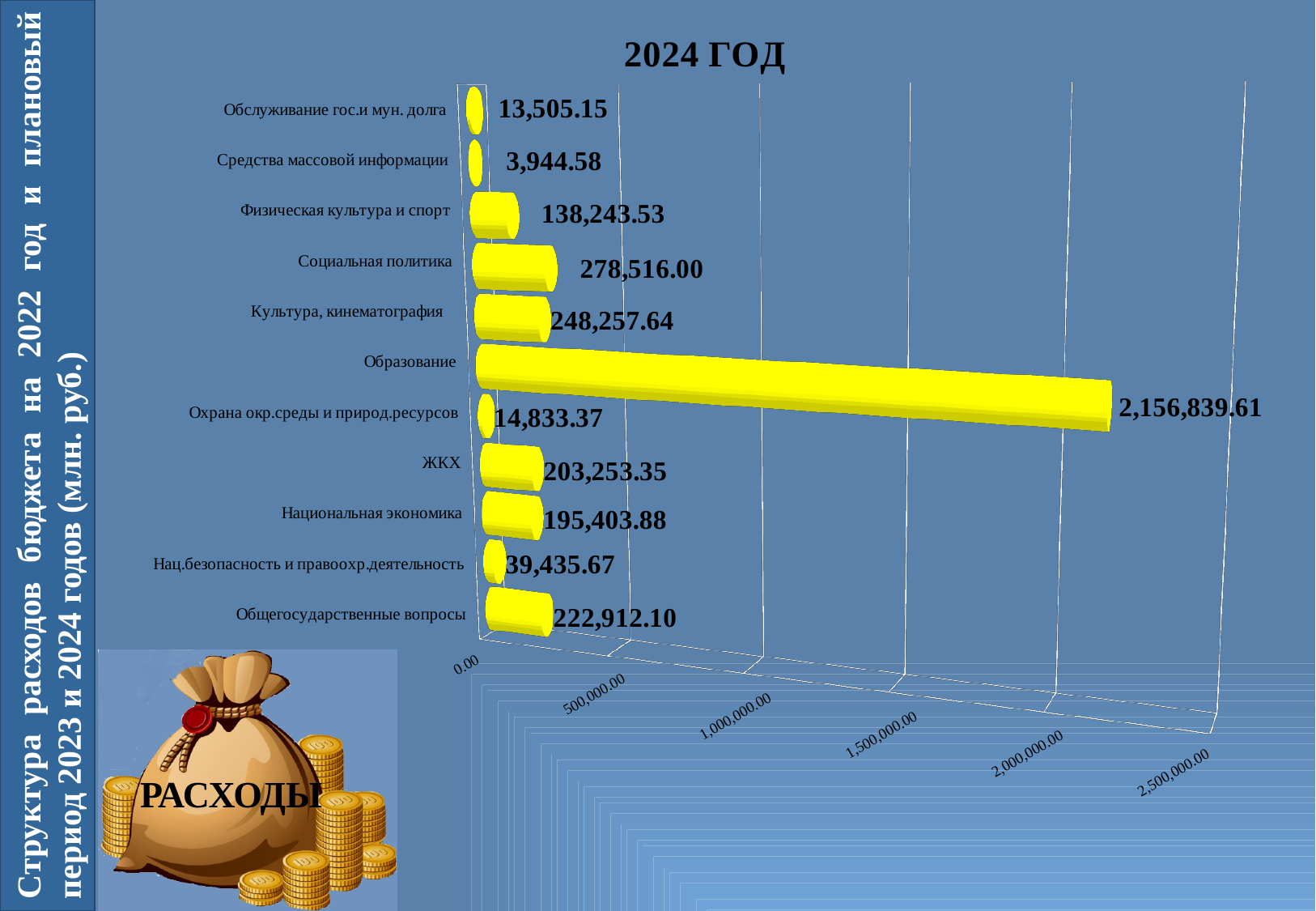
Which is larger, Национальная экономика or Физическая культура и спорт? Национальная экономика What is the difference between Социальная политика and Культура, кинематография? 30,258.36 What is the value for Образование? 2,156,839.61 What is the difference between Общегосударственные вопросы and ЖКХ? 19,658.75 What is the title of the chart? 2024 ГОД Which category has the lowest value? Средства массовой информации How many categories are shown in the chart? 11 What is the value for ЖКХ? 203,253.35 What kind of chart is shown? Bar chart Which category has the highest value? Образование What is the value for Социальная политика? 278,516.00 What is the value for Средства массовой информации? 3,944.58